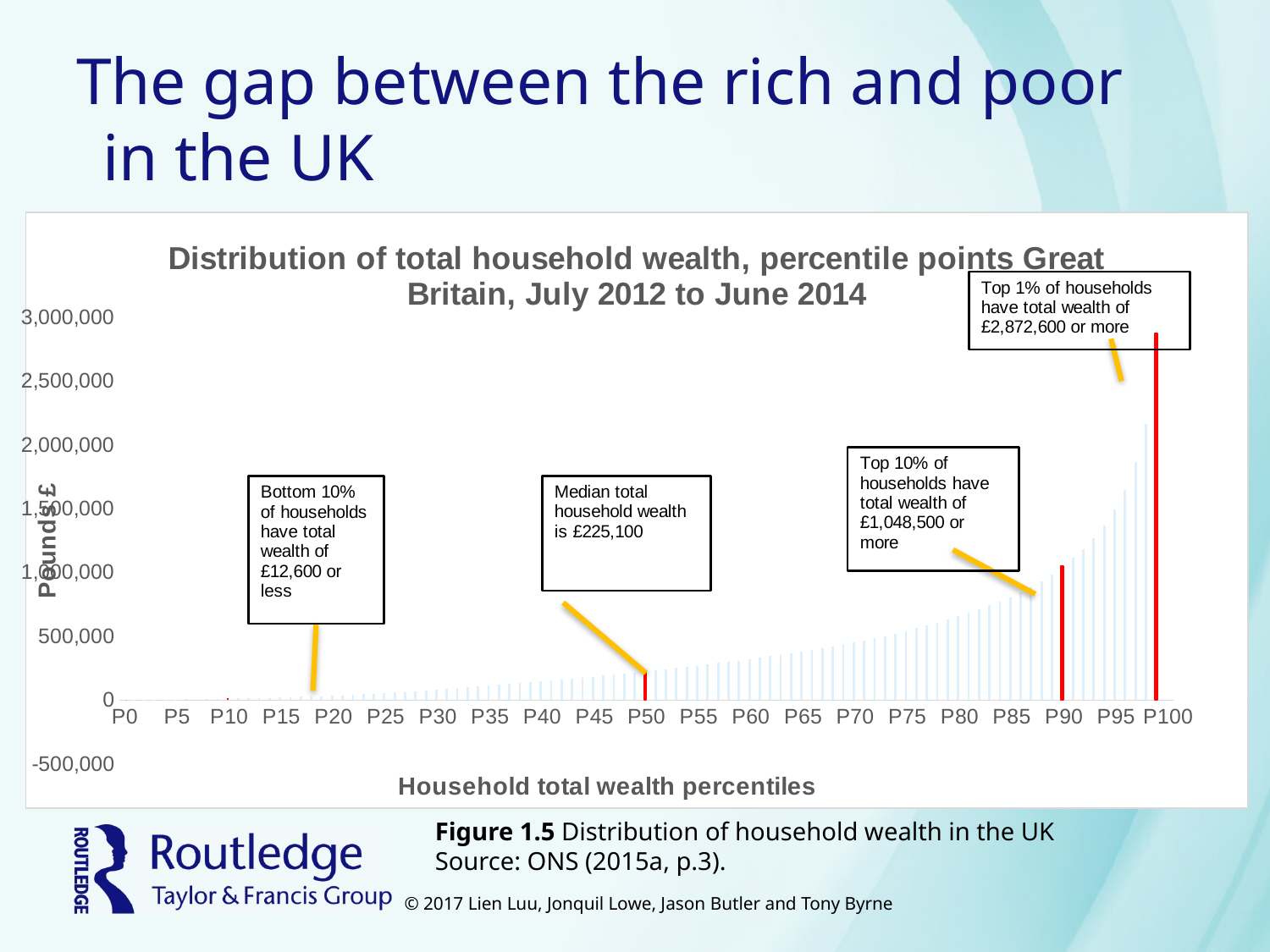
Is the value for P100 greater or less than 2,500,000? greater According to the annotation, the top 1% of households have total wealth of what amount or more? £2,872,600 What type of chart is shown on the slide? bar chart What is the label of the vertical axis? Pounds £ What is the difference between the median household wealth (£225,100) and the bottom 10% threshold (£12,600)? £212,500 Which percentile has the highest total household wealth on the chart? P100 According to the annotation, the bottom 10% of households have total wealth of what amount or less? £12,600 According to the annotation, the top 10% of households have total wealth of what amount or more? £1,048,500 Is the value for P60 greater or less than 500,000? less According to the annotation, what is the median total household wealth? £225,100 What is the difference between the top 10% threshold (£1,048,500) and the median household wealth (£225,100)? £823,400 Do the values rise or fall as the percentiles increase from P0 to P100? rise